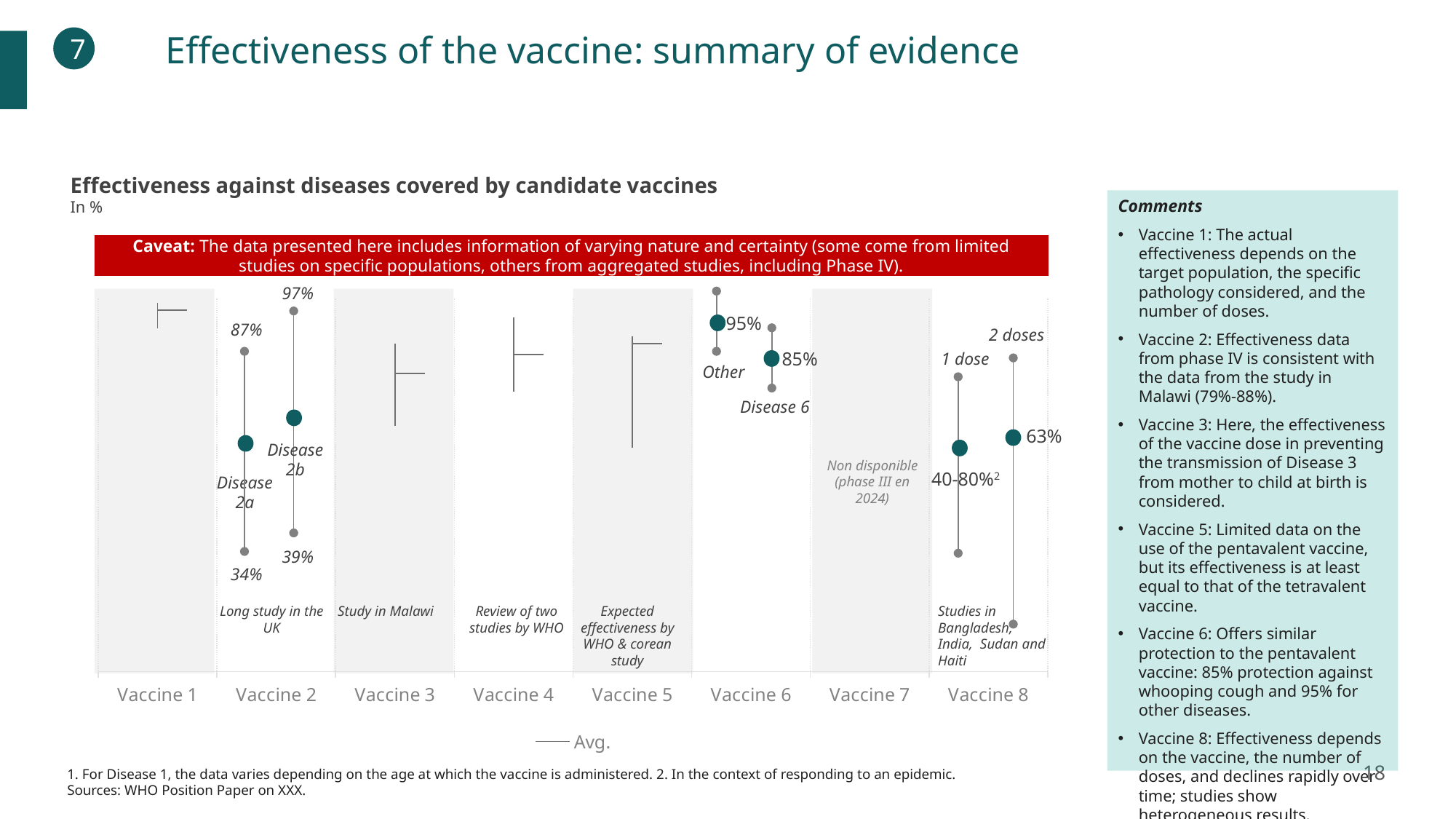
What is the lower value of the range shown for Disease 2b under Vaccine 2? 39% What does the legend entry below the chart represent? Avg. What is the effectiveness value shown for Disease 6 under Vaccine 6? 85% How many vaccine categories are shown along the x axis? 8 What range is printed for 1 dose under Vaccine 8? 40-80% What is the highest effectiveness value printed on the chart? 97% What is the upper value of the range shown for Disease 2a under Vaccine 2? 87% Under Vaccine 6, which is higher: the value for 'Other' or the value for Disease 6? Other What is the difference between the 'Other' value and the Disease 6 value under Vaccine 6? 10% What is the effectiveness value shown for 2 doses under Vaccine 8? 63% What is the effectiveness value shown for 'Other' under Vaccine 6? 95% What is the difference between the upper and lower values of the Disease 2b range under Vaccine 2? 58%